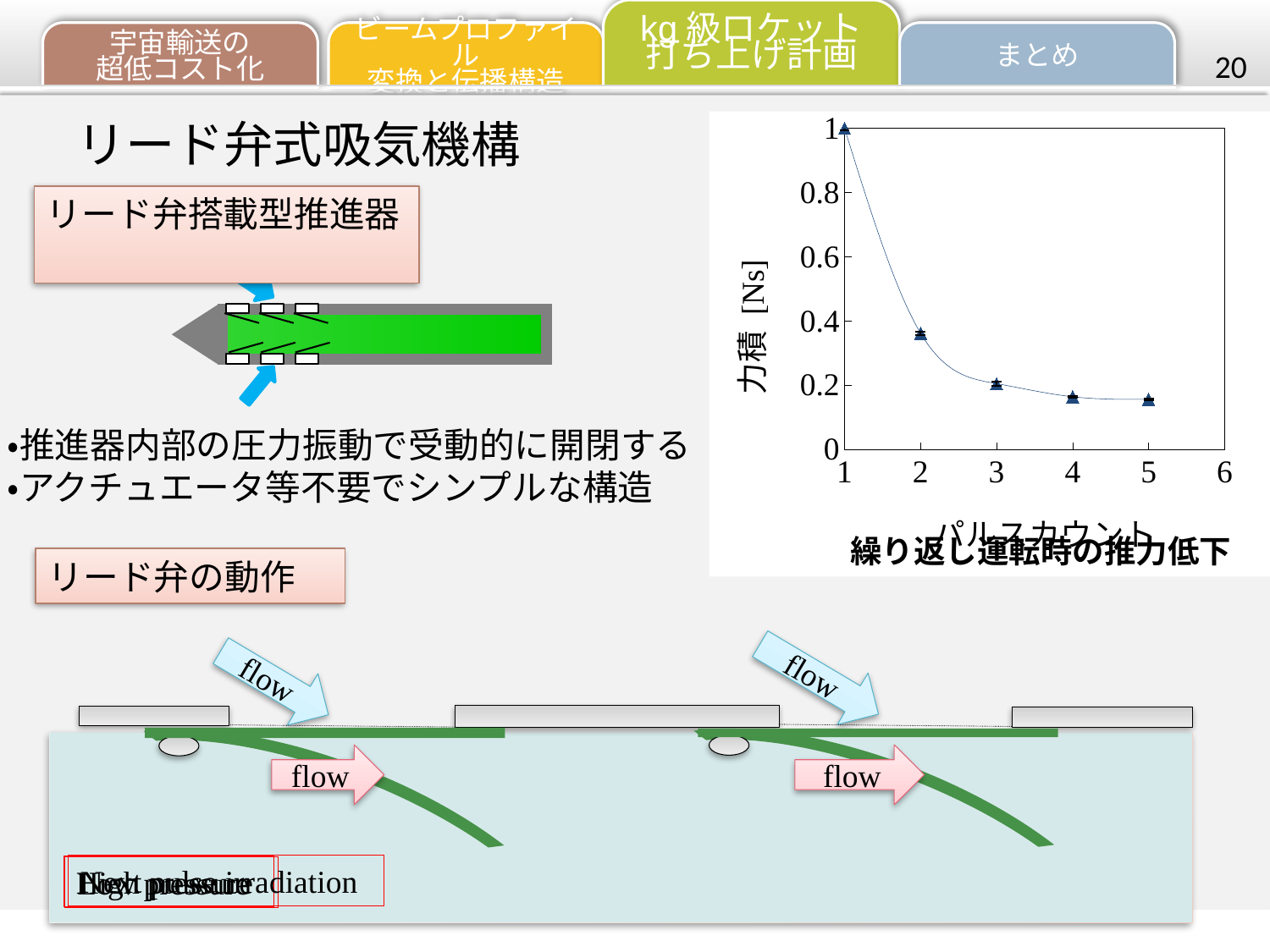
What is the label of the y axis of the chart? 力積 [Ns] Do the plotted values rise or fall as the pulse count increases? fall What is the impulse value at pulse count 1? 1 Is the impulse value at pulse count 2 greater or less than 0.4? less Is the impulse value at pulse count 4 greater or less than 0.2? less Is the impulse value at pulse count 3 greater or less than 0.4? less Which has the larger impulse value, pulse count 2 or pulse count 3? pulse count 2 At which pulse count is the impulse (力積) highest? 1 What kind of chart is shown on the slide? line chart What is the label of the x axis of the chart? パルスカウント How many data points are plotted on the chart? 5